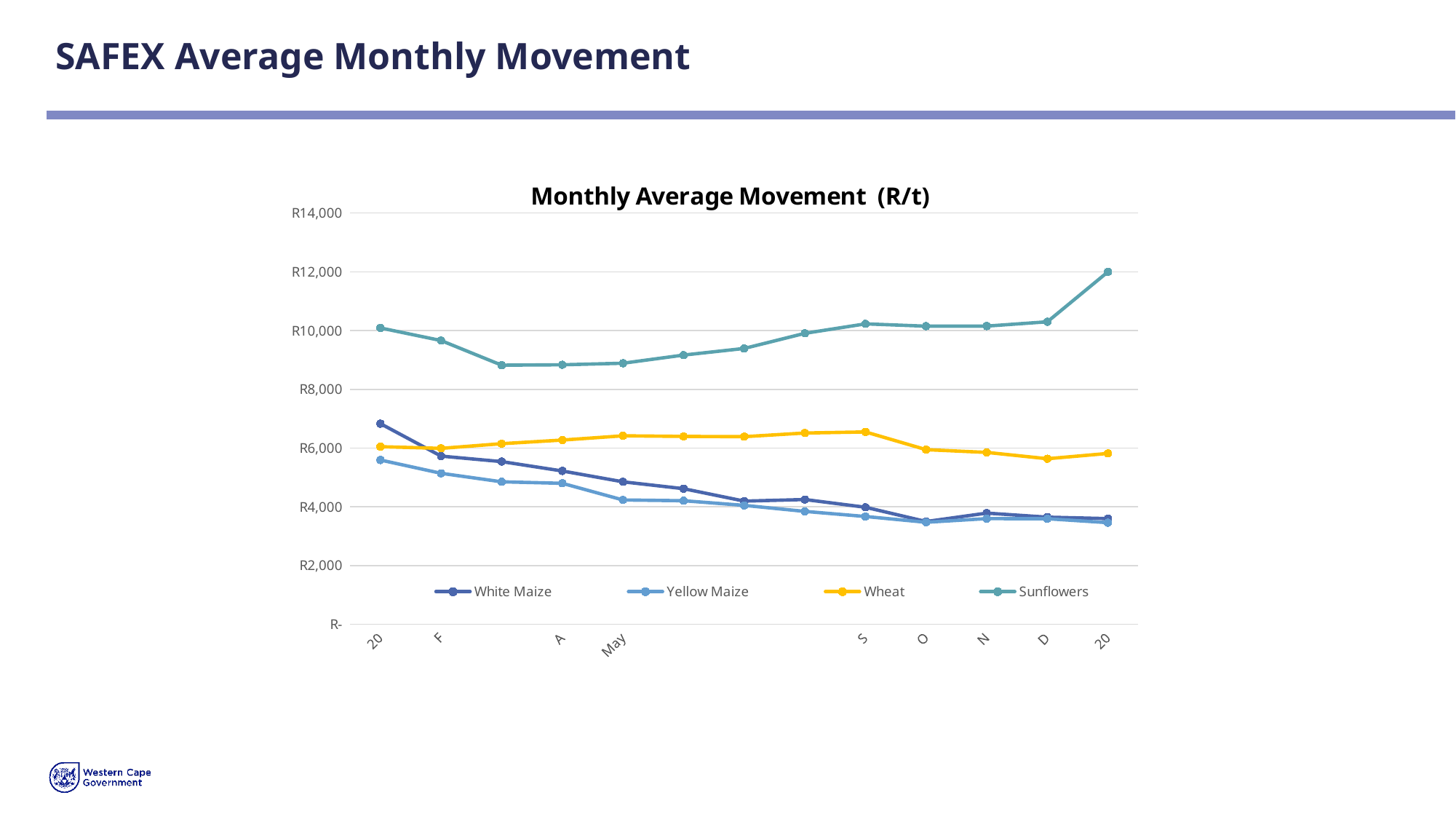
Is the value for Sunflowers at A greater or less than R8,000? greater At the first point on the x axis, which is higher, White Maize or Yellow Maize? White Maize How many series does the legend list? 4 Do the White Maize values generally rise or fall along the x axis? fall Which series has the lowest value at the first point on the x axis? Yellow Maize What kind of chart is shown on the slide? line chart What is the title of the chart? Monthly Average Movement (R/t) Is the value for Yellow Maize at O greater or less than R4,000? less Is the value for Wheat at S greater or less than R6,000? greater At S, which is higher, Wheat or White Maize? Wheat Which series has the highest values across the whole chart? Sunflowers How many data points does each line have? 13